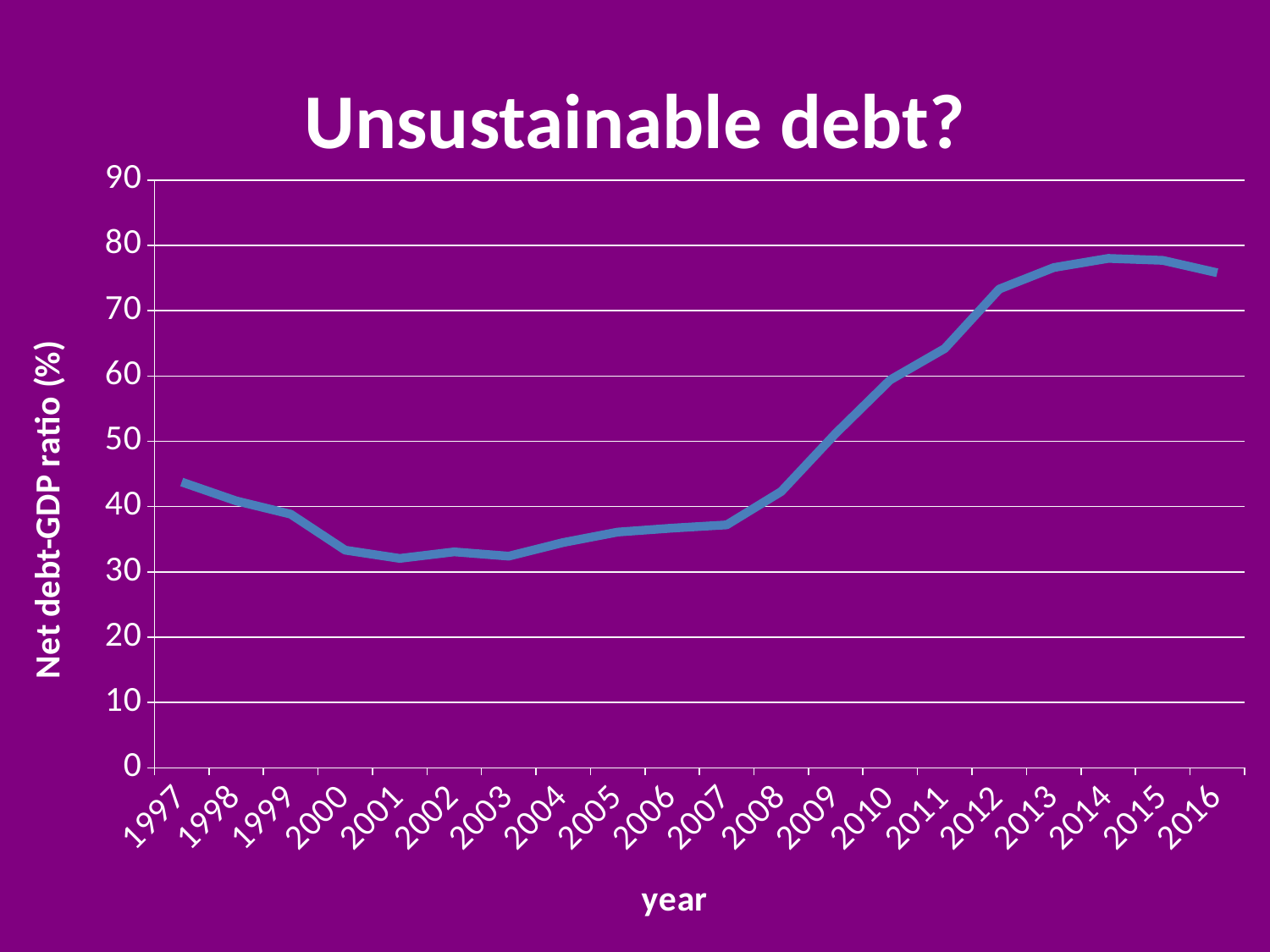
How many years are plotted along the x axis? 20 Which year has the larger value, 2010 or 2000? 2010 Is the value for 2001 greater or less than 40? less Is the value for 2012 greater or less than 70? greater Which year has the larger value, 1997 or 2003? 1997 Is the value for 2014 greater or less than 70? greater What is the label of the vertical axis? Net debt-GDP ratio (%) What kind of chart is shown on the slide? line chart Does the net debt-GDP ratio rise or fall between 2007 and 2012? rise What is the title of the chart? Unsustainable debt?